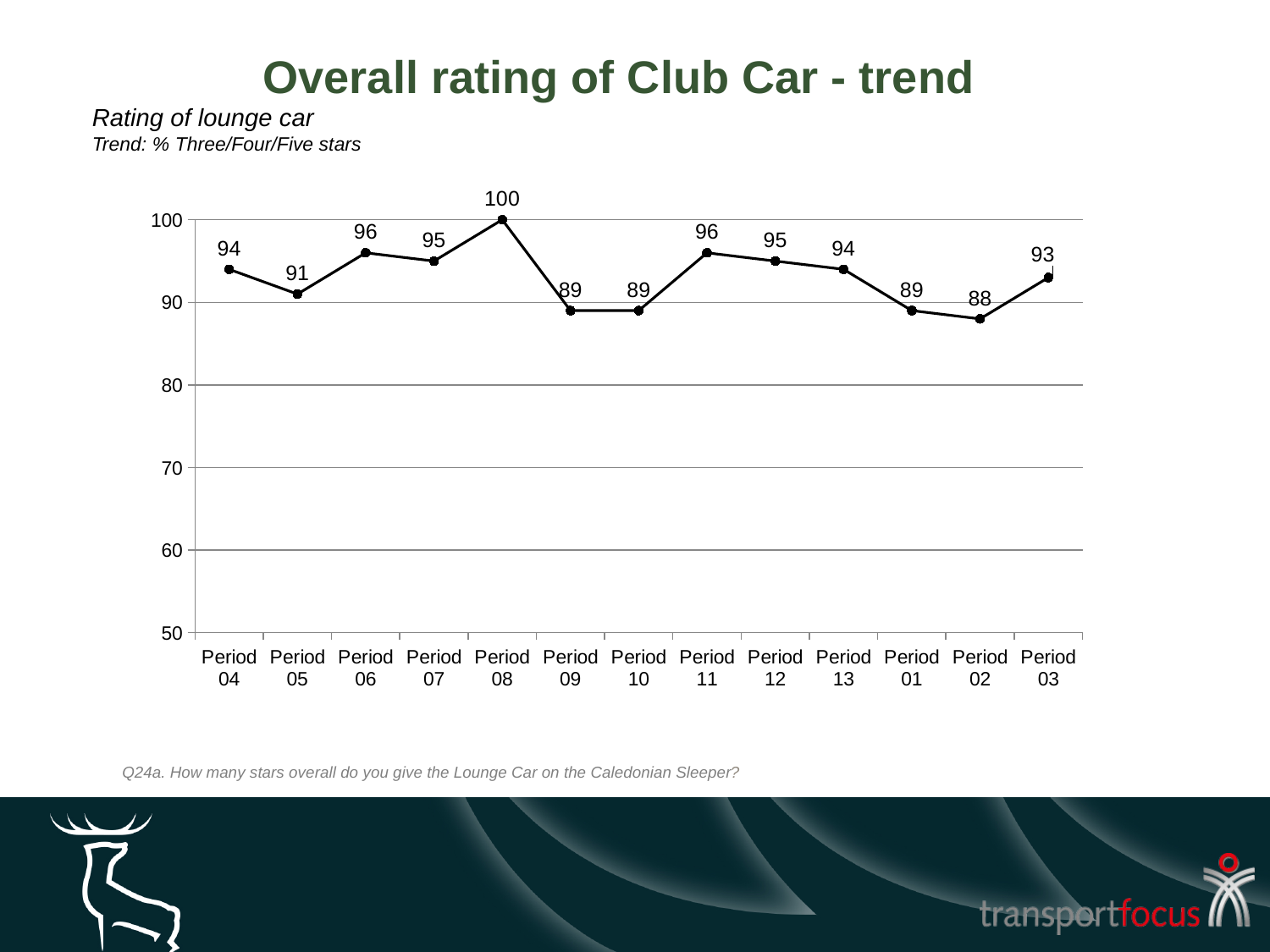
Which period has the lowest value? Period 02 What is the title of the slide? Overall rating of Club Car - trend Is the value for Period 10 greater or less than 90? less Does the value rise or fall from Period 08 to Period 09? fall What kind of chart is shown on the slide? line chart Which period has the highest value? Period 08 What is the value for Period 03? 93 What is the value for Period 02? 88 What is the difference between the values for Period 08 and Period 09? 11 How many periods are plotted on the chart? 13 Which is larger, the value for Period 05 or the value for Period 06? Period 06 What is the value for Period 08? 100